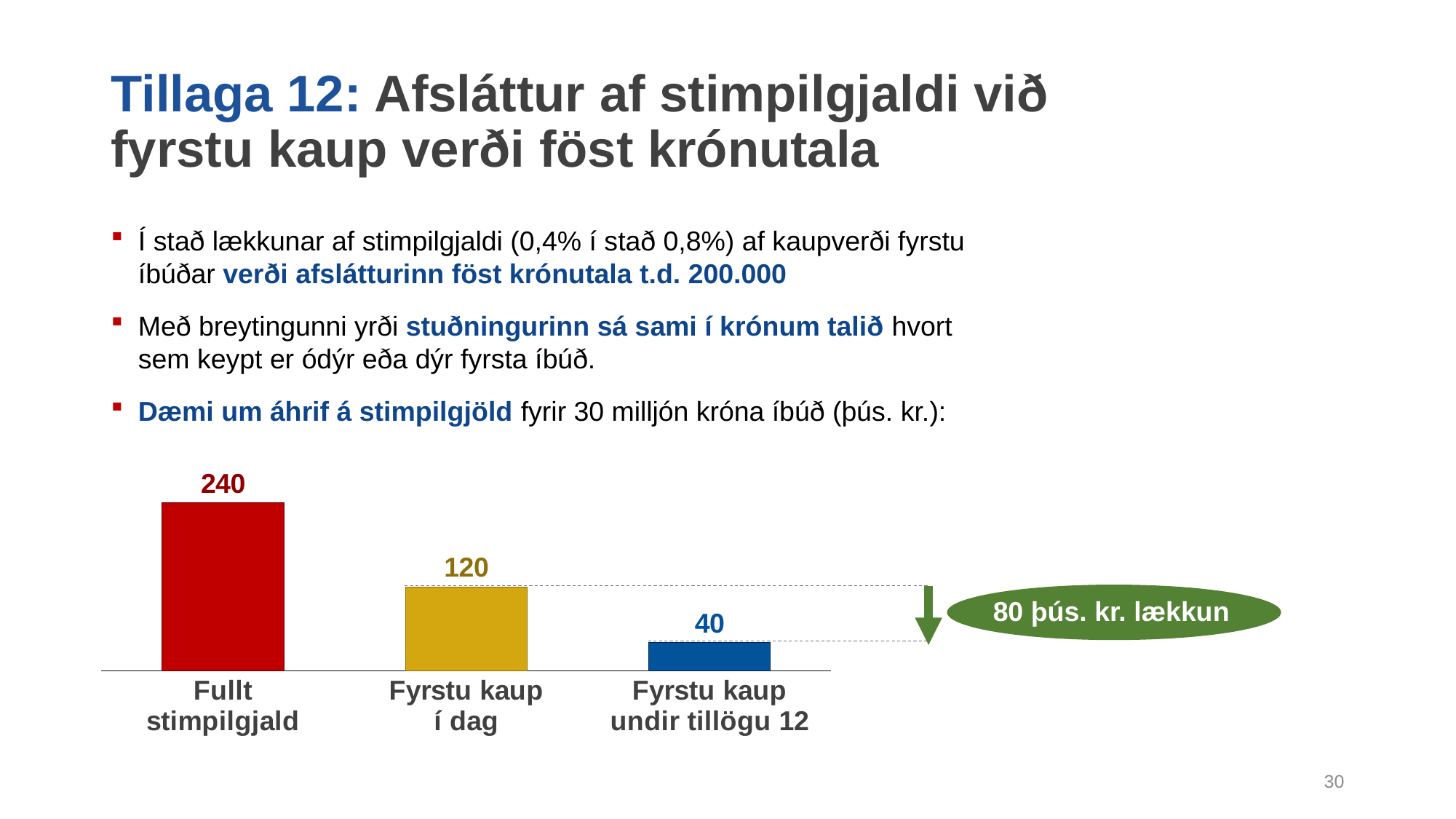
What is the value for "Fyrstu kaup undir tillögu 12"? 40 What is the value for "Fyrstu kaup í dag"? 120 What is the difference between "Fullt stimpilgjald" and "Fyrstu kaup í dag"? 120 What kind of chart is shown on the slide? Bar chart Which is larger, "Fyrstu kaup í dag" or "Fyrstu kaup undir tillögu 12"? Fyrstu kaup í dag How many categories are shown in the chart? 3 What is the value for "Fullt stimpilgjald"? 240 What is the difference between "Fyrstu kaup í dag" and "Fyrstu kaup undir tillögu 12"? 80 Which category has the highest value? Fullt stimpilgjald Which category has the lowest value? Fyrstu kaup undir tillögu 12 What does the green oval next to the chart say? 80 þús. kr. lækkun Do the values rise or fall from left to right across the categories? Fall